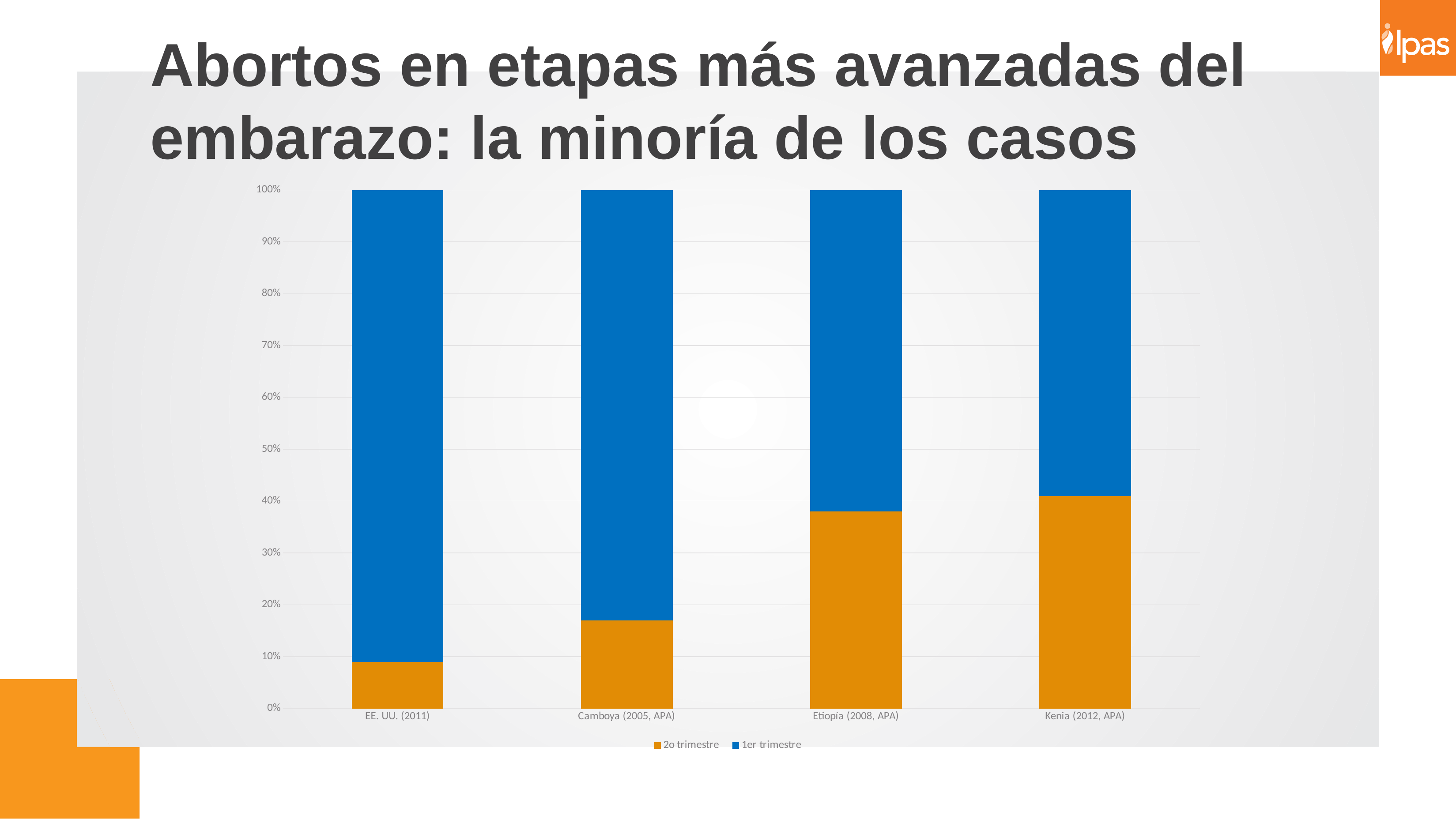
Does the 2o trimestre share rise or fall from left to right across the categories? Rise Which has a larger 2o trimestre share, Etiopía (2008, APA) or Camboya (2005, APA)? Etiopía (2008, APA) Which category has the largest 1er trimestre share? EE. UU. (2011) What is the total height of each stacked bar? 100% Is the 2o trimestre value for Kenia (2012, APA) greater or less than 40%? greater Which colour represents 1er trimestre in the legend? Blue How many countries (categories) are shown on the x axis? 4 What kind of chart is shown on the slide? Stacked bar chart Is the 2o trimestre value for Camboya (2005, APA) greater or less than 20%? less How many series does the legend list? 2 Is the 2o trimestre value for EE. UU. (2011) greater or less than 10%? less Which category has the smallest 2o trimestre share? EE. UU. (2011)